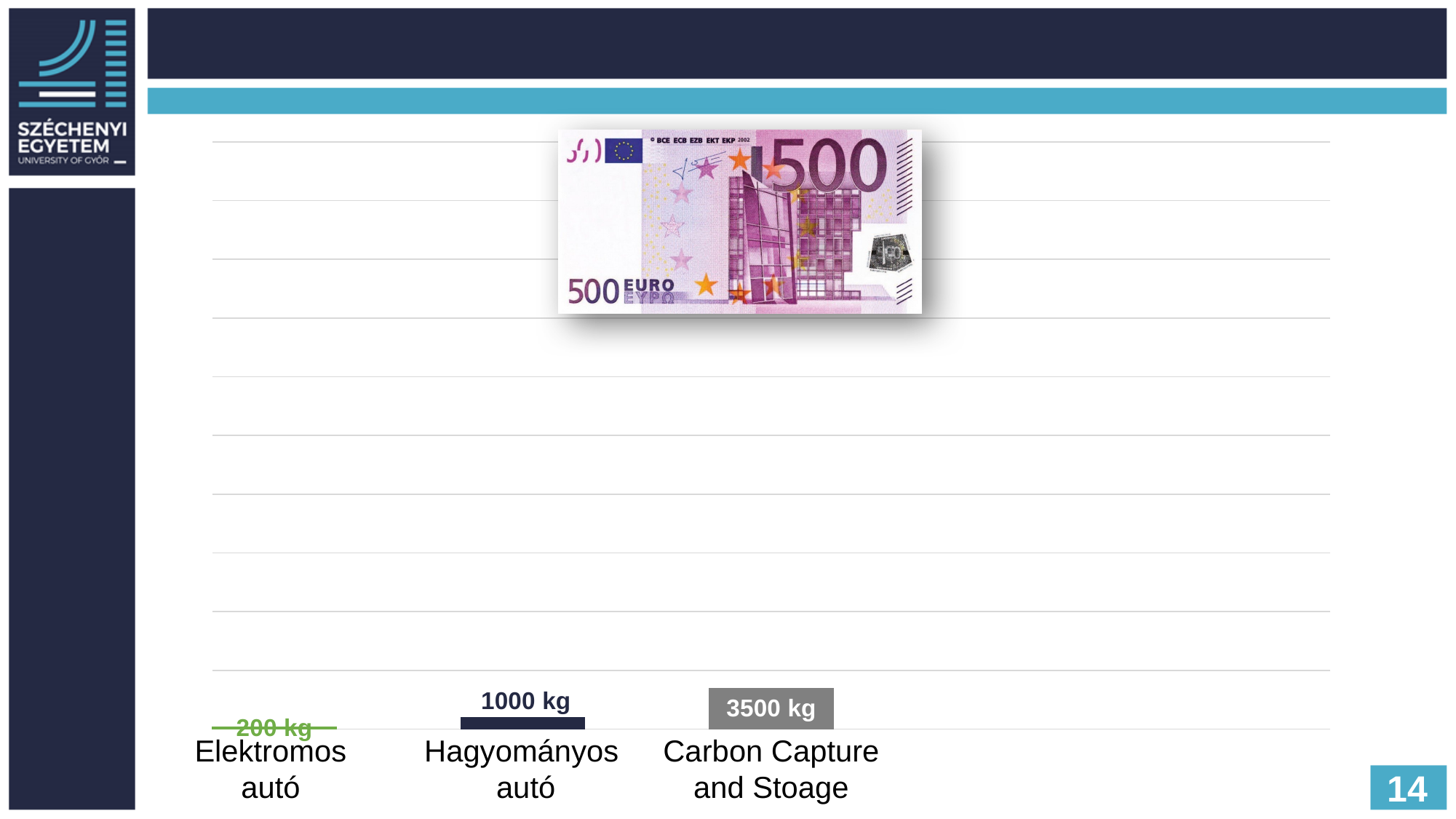
How many categories are shown in the chart? 3 Which category has the lowest value? Elektromos autó What is the difference between the values for Hagyományos autó and Elektromos autó? 800 kg What value is shown for Elektromos autó? 200 kg What kind of chart is shown on the slide? bar chart What colour is the bar for Carbon Capture and Stoage? grey What value is shown for Hagyományos autó? 1000 kg Do the values rise or fall from left to right across the categories? rise Which is larger, the value for Hagyományos autó or the value for Elektromos autó? Hagyományos autó Which category has the highest value? Carbon Capture and Stoage What is the difference between the values for Carbon Capture and Stoage and Hagyományos autó? 2500 kg What value is shown for Carbon Capture and Stoage? 3500 kg